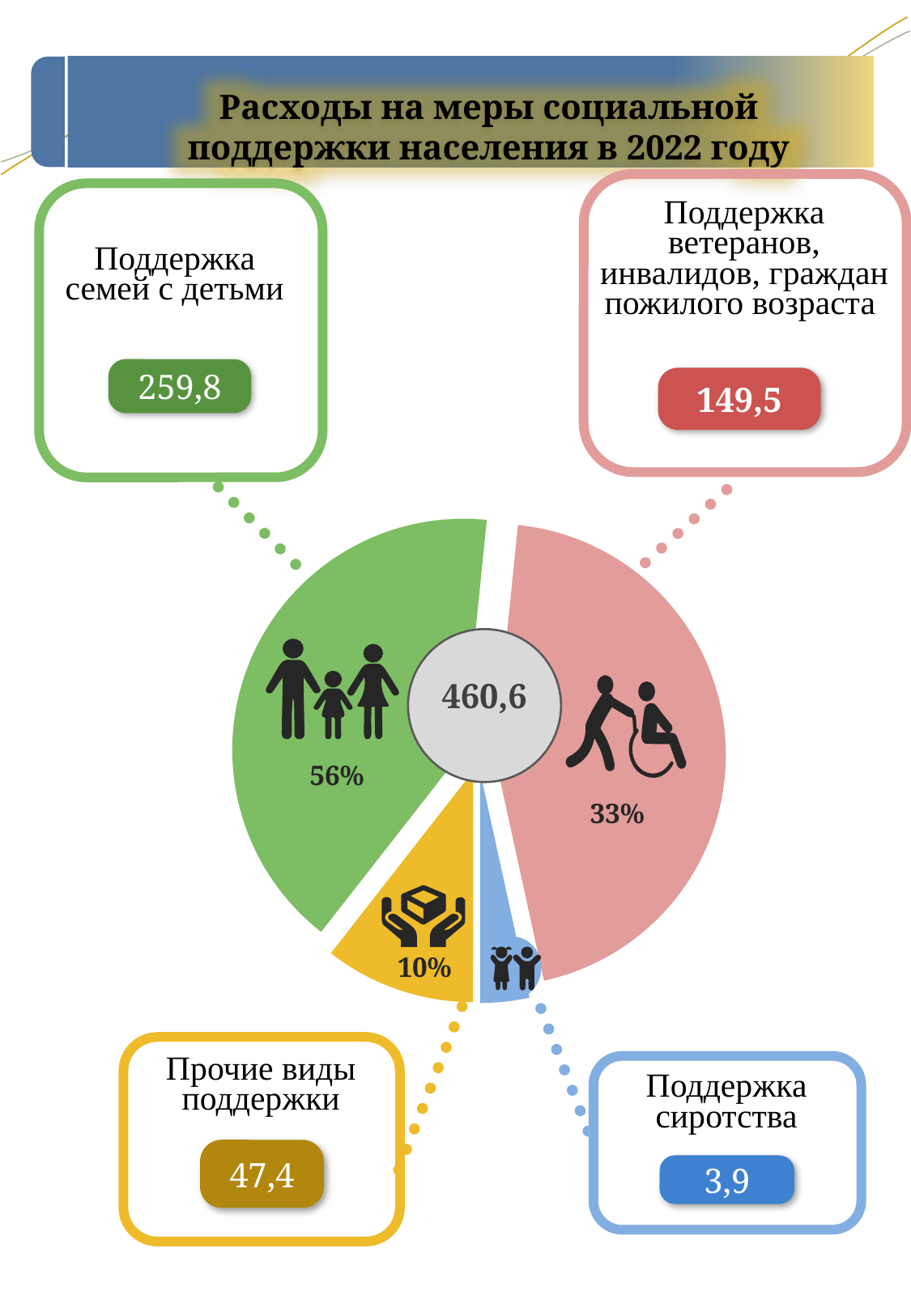
How many slices does the pie chart have? 4 What is the value for Поддержка ветеранов, инвалидов, граждан пожилого возраста? 149,5 What total value is shown in the centre of the pie chart? 460,6 What share of the pie does Поддержка ветеранов, инвалидов, граждан пожилого возраста take? 33% What is the value for Прочие виды поддержки? 47,4 What type of chart is shown on the slide? pie chart What is the difference between the values for Поддержка семей с детьми and Поддержка ветеранов, инвалидов, граждан пожилого возраста? 110,3 Which category has the smallest slice of the pie? Поддержка сиротства What is the value for Поддержка сиротства? 3,9 Which category has the largest slice of the pie? Поддержка семей с детьми What is the value for Поддержка семей с детьми? 259,8 What share of the pie does Поддержка семей с детьми take? 56%